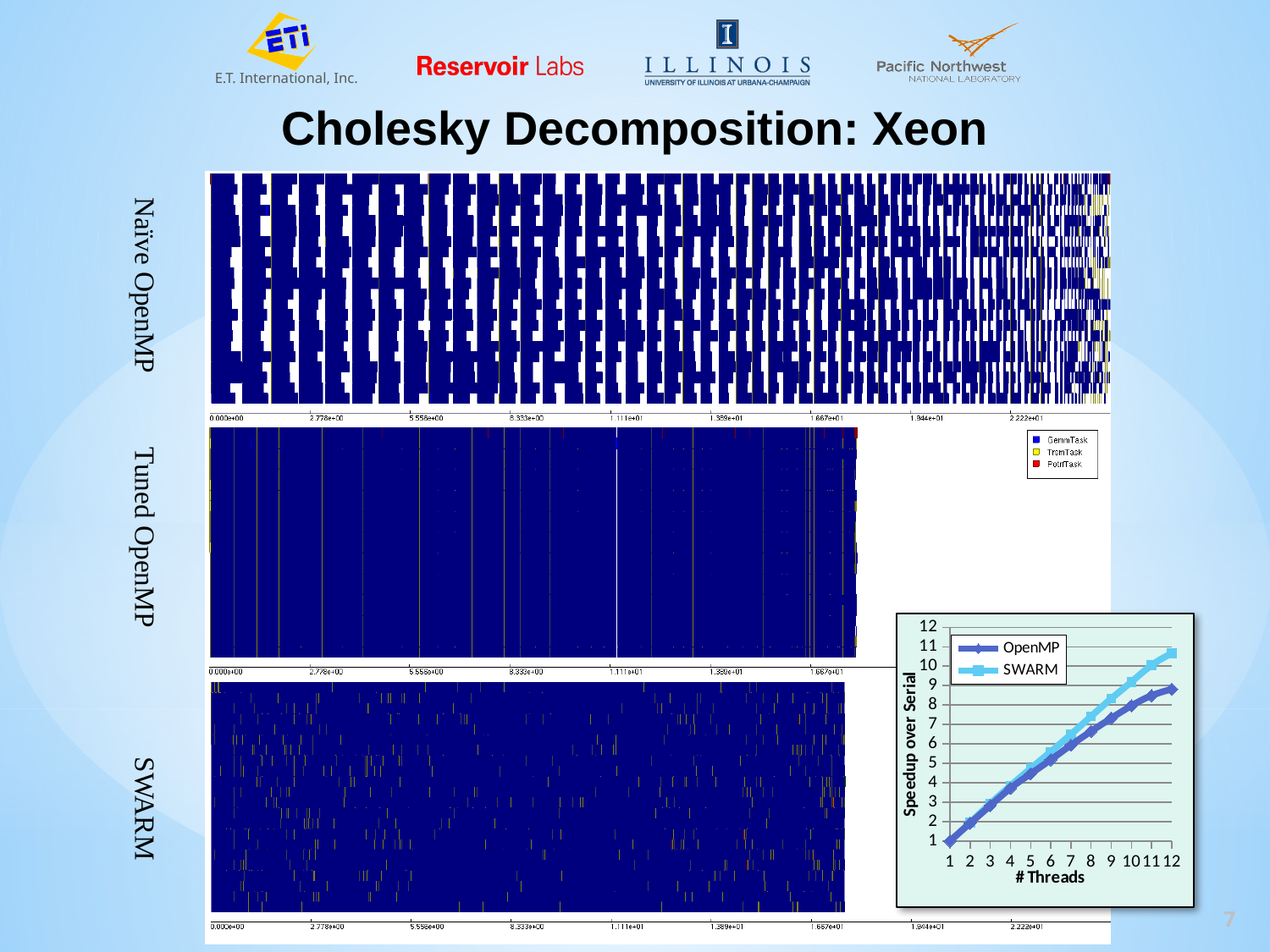
In the speedup chart, is the OpenMP speedup at 12 threads greater or less than 10? less What kind of chart is the speedup chart in the lower right of the slide? line chart In the speedup chart, is the SWARM speedup at 12 threads greater or less than 10? greater In the speedup chart, which series achieves the highest speedup overall? SWARM In the speedup chart, which series reaches the higher speedup at 12 threads, OpenMP or SWARM? SWARM In the speedup chart, how many thread counts are plotted along the x axis? 12 In the speedup chart, is the OpenMP speedup at 4 threads greater or less than 5? less How many series does the legend of the speedup chart list? 2 Which two series are shown in the speedup chart's legend? OpenMP and SWARM What is the label of the y axis of the speedup chart? Speedup over Serial In the speedup chart, does the speedup rise or fall as the number of threads increases? rises